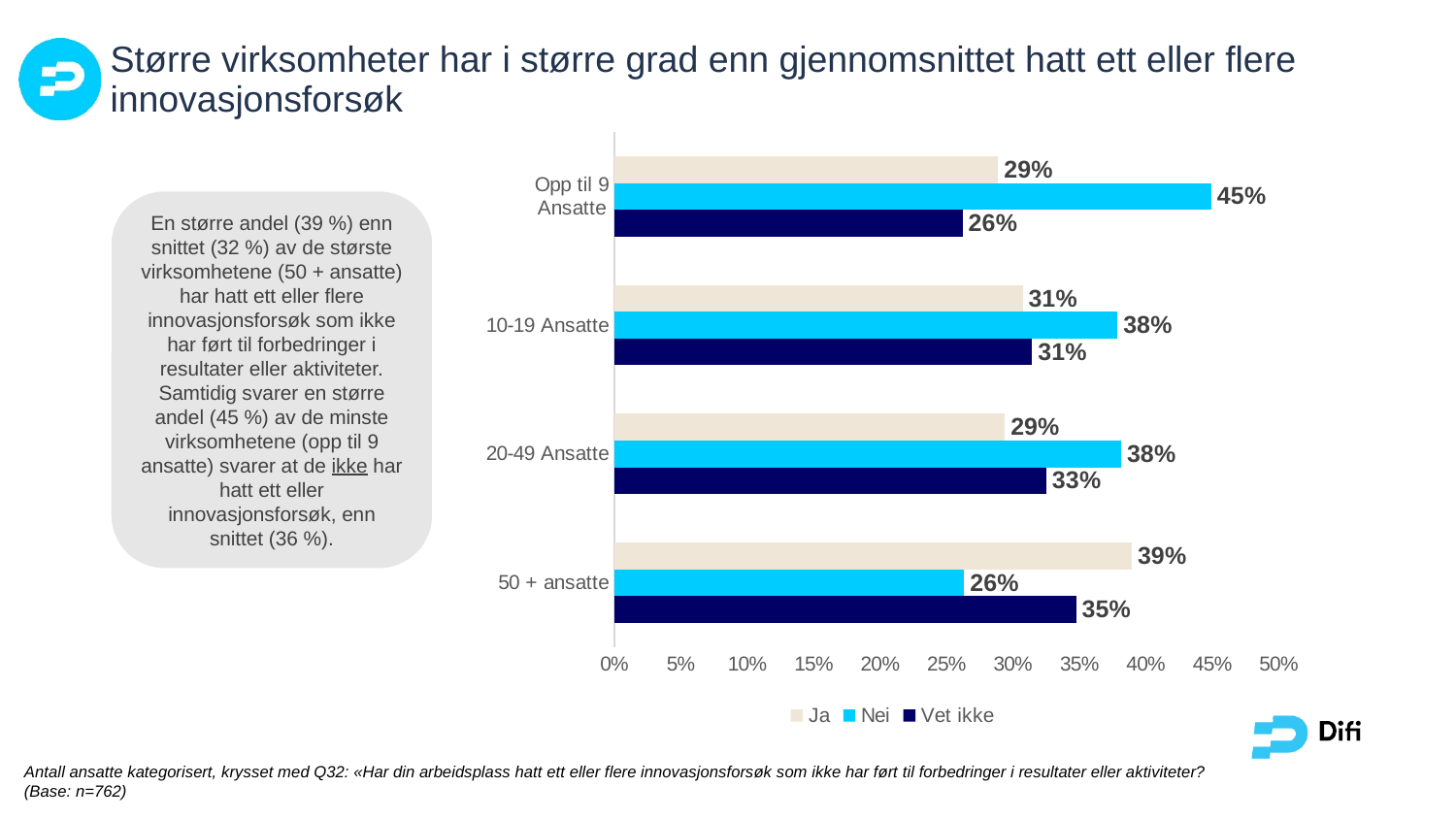
How many series does the legend list? 3 Is the 'Vet ikke' value for 'Opp til 9 Ansatte' greater or less than 30%? less Which category has the highest 'Ja' value? 50 + ansatte What is the difference between the 'Nei' value for 'Opp til 9 Ansatte' and the 'Nei' value for '50 + ansatte'? 19% Which is larger for '10-19 Ansatte': the 'Ja' value or the 'Nei' value? Nei How many employee-size categories are shown on the chart? 4 What is the 'Ja' value for '50 + ansatte'? 39% Which category has the lowest 'Nei' value? 50 + ansatte What is the 'Vet ikke' value for '20-49 Ansatte'? 33% What is the 'Nei' value for 'Opp til 9 Ansatte'? 45% What are the legend entries of the chart? Ja, Nei, Vet ikke What kind of chart is shown on the slide? bar chart